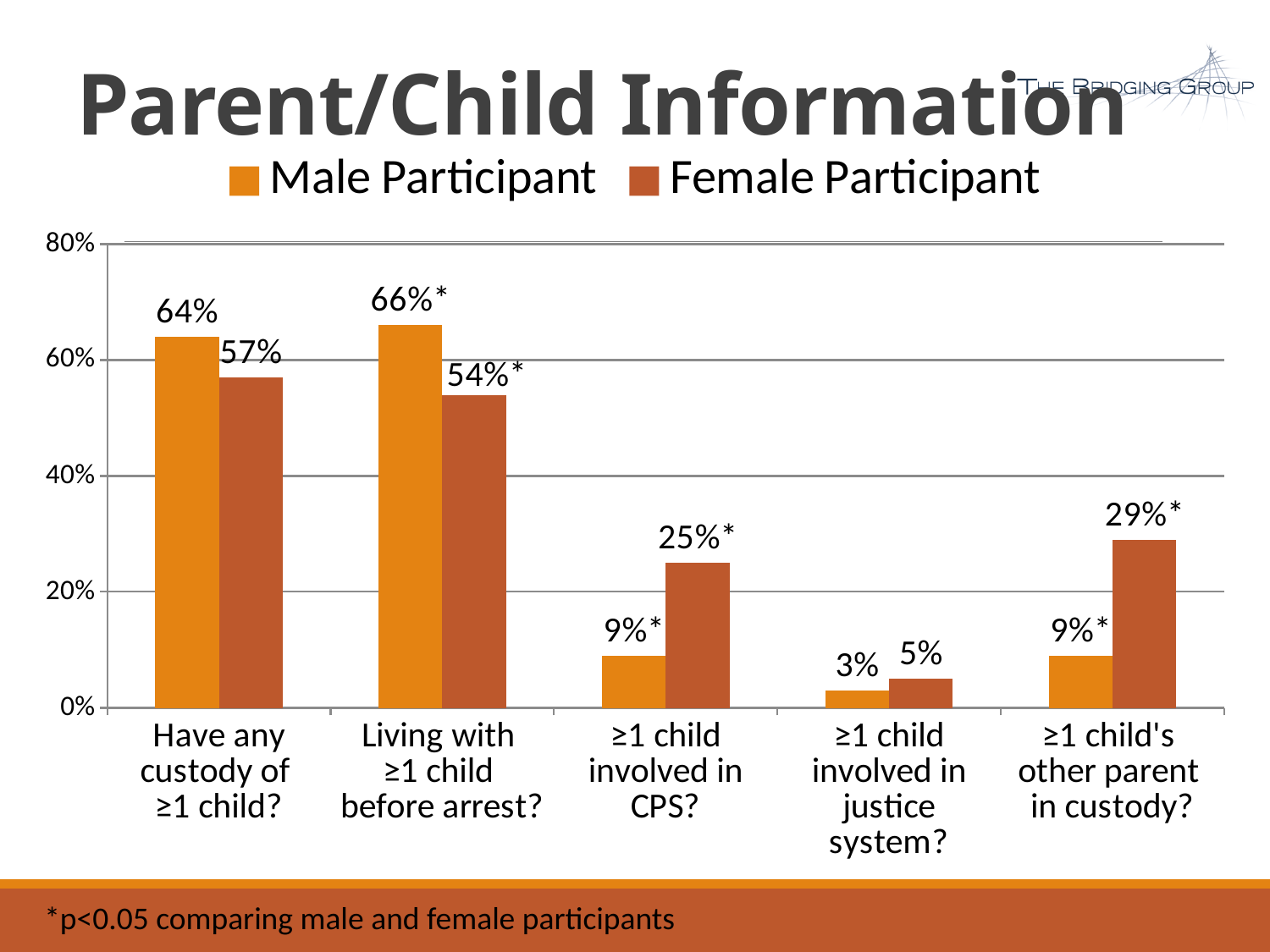
Which category has the lowest Female Participant value? ≥1 child involved in justice system? What kind of chart is shown on the slide? Bar chart For "Have any custody of ≥1 child?", which is larger: the Male Participant value or the Female Participant value? Male Participant How many categories are shown on the x axis? 5 What is the value for Male Participant for "Have any custody of ≥1 child?"? 64% What is the value for Female Participant for "≥1 child's other parent in custody?"? 29% How many series does the legend list? 2 Is the Female Participant value for "≥1 child's other parent in custody?" greater or less than 20%? greater What is the title of the slide? Parent/Child Information What is the difference between the Female Participant and Male Participant values for "≥1 child involved in CPS?"? 16% What is the value for Female Participant for "Living with ≥1 child before arrest?"? 54% Which category has the highest Male Participant value? Living with ≥1 child before arrest?